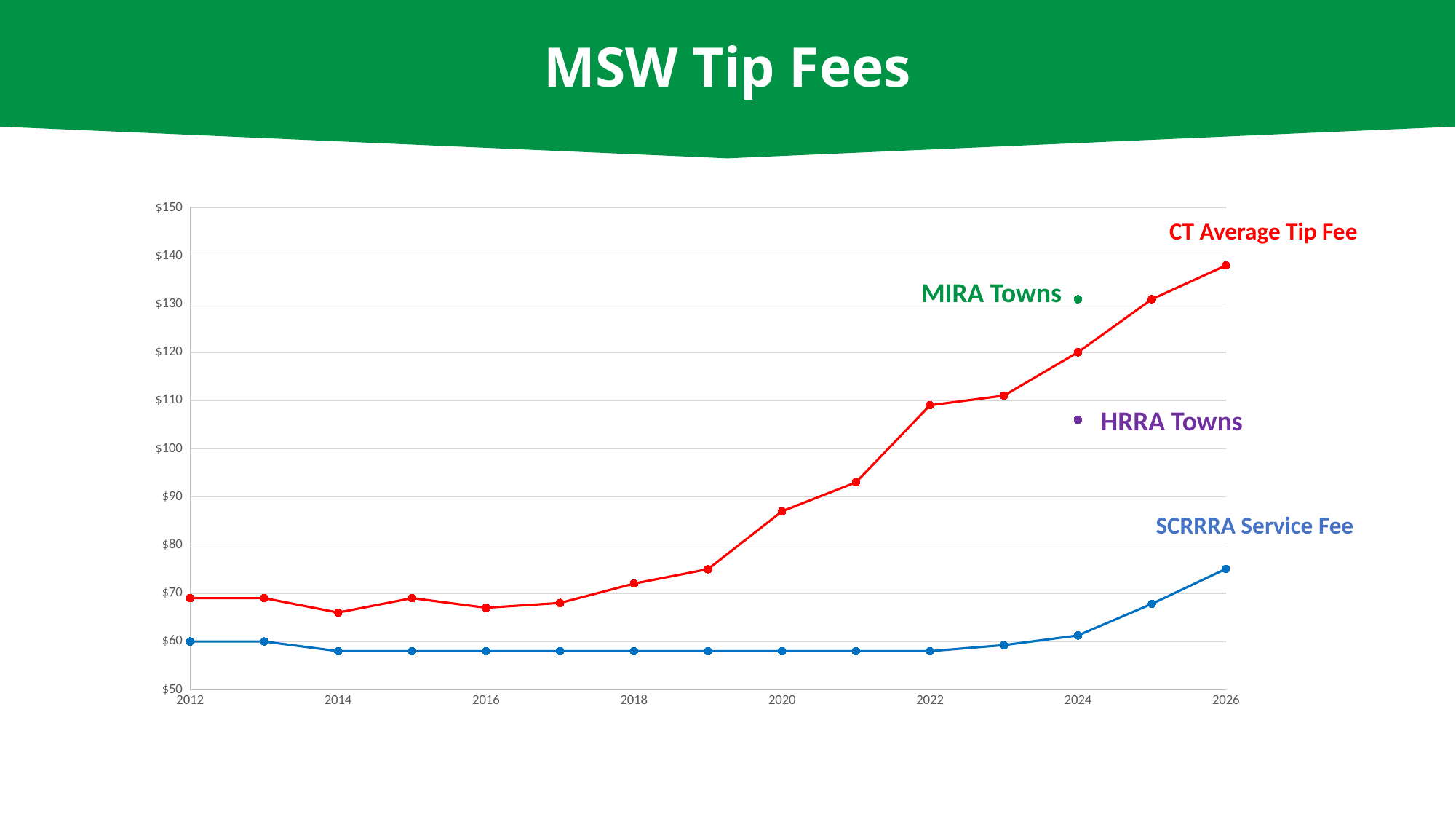
Is the CT Average Tip Fee value for 2022 greater or less than $100? greater Is the SCRRRA Service Fee value for 2026 greater or less than $80? less Is the MIRA Towns value greater or less than $120? greater What is the title of the chart? MSW Tip Fees How many labelled series are plotted on the chart? 4 Which is higher, the MIRA Towns value or the HRRA Towns value? MIRA Towns What kind of chart is shown on the slide? line chart Does the CT Average Tip Fee rise or fall from 2019 to 2026? rise Which is higher in 2024, the CT Average Tip Fee or the SCRRRA Service Fee? CT Average Tip Fee